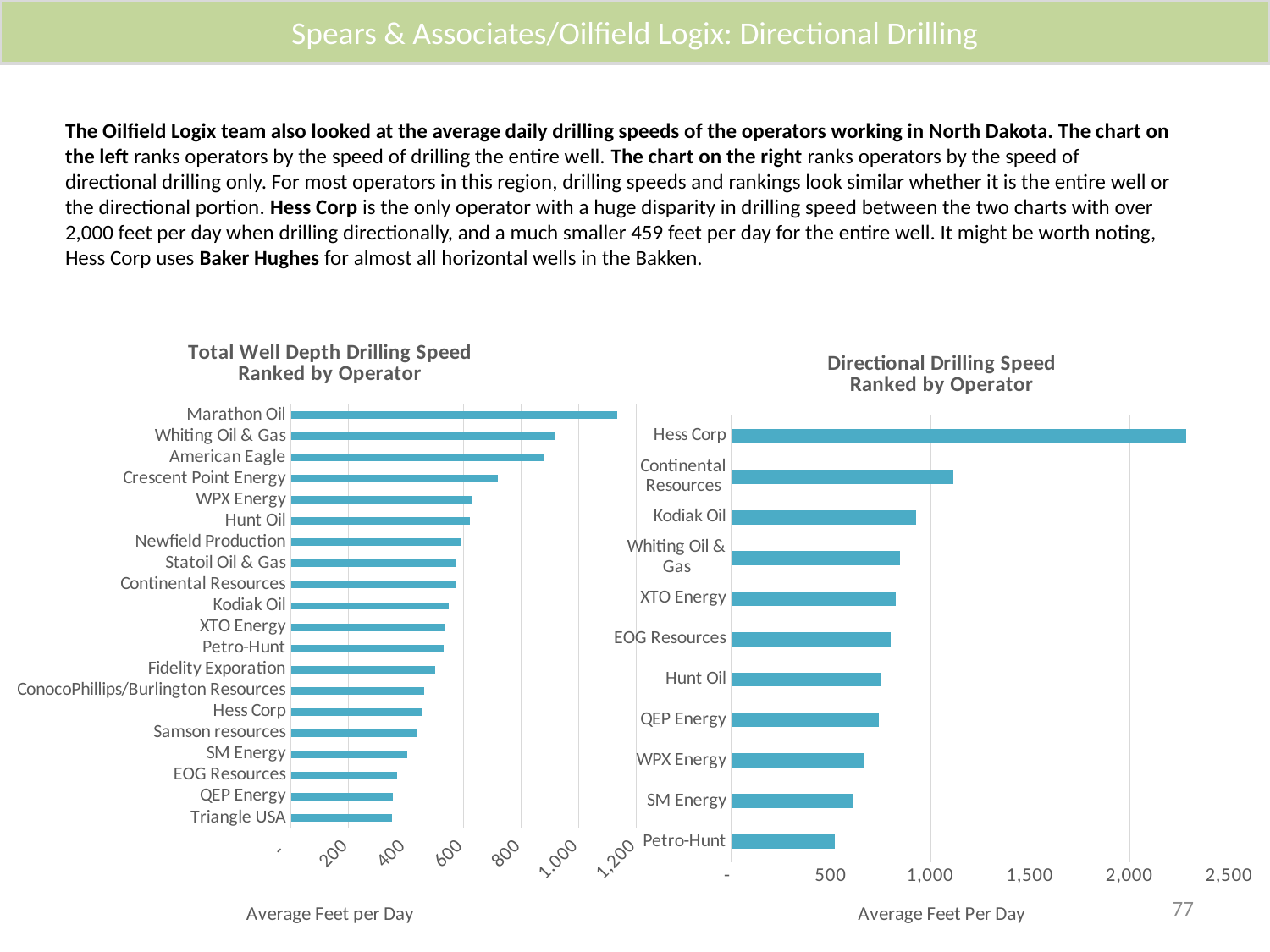
In the 'Directional Drilling Speed Ranked by Operator' chart, is the value for Kodiak Oil greater or less than 1,000? less In the 'Directional Drilling Speed Ranked by Operator' chart, which has the larger value, Hess Corp or Continental Resources? Hess Corp In the 'Total Well Depth Drilling Speed Ranked by Operator' chart, is the value for Marathon Oil greater or less than 1,000? greater How many operators are listed in the 'Total Well Depth Drilling Speed Ranked by Operator' chart on the left? 20 In the 'Directional Drilling Speed Ranked by Operator' chart, which operator has the highest drilling speed? Hess Corp What is the x-axis label of the 'Directional Drilling Speed Ranked by Operator' chart on the right? Average Feet Per Day In the 'Total Well Depth Drilling Speed Ranked by Operator' chart, is the value for Hess Corp greater or less than 600? less What type of chart is the 'Total Well Depth Drilling Speed Ranked by Operator' chart on the left? bar chart In the 'Total Well Depth Drilling Speed Ranked by Operator' chart, which operator has the highest drilling speed? Marathon Oil In the 'Directional Drilling Speed Ranked by Operator' chart, which operator has the lowest drilling speed? Petro-Hunt How many operators are listed in the 'Directional Drilling Speed Ranked by Operator' chart on the right? 11